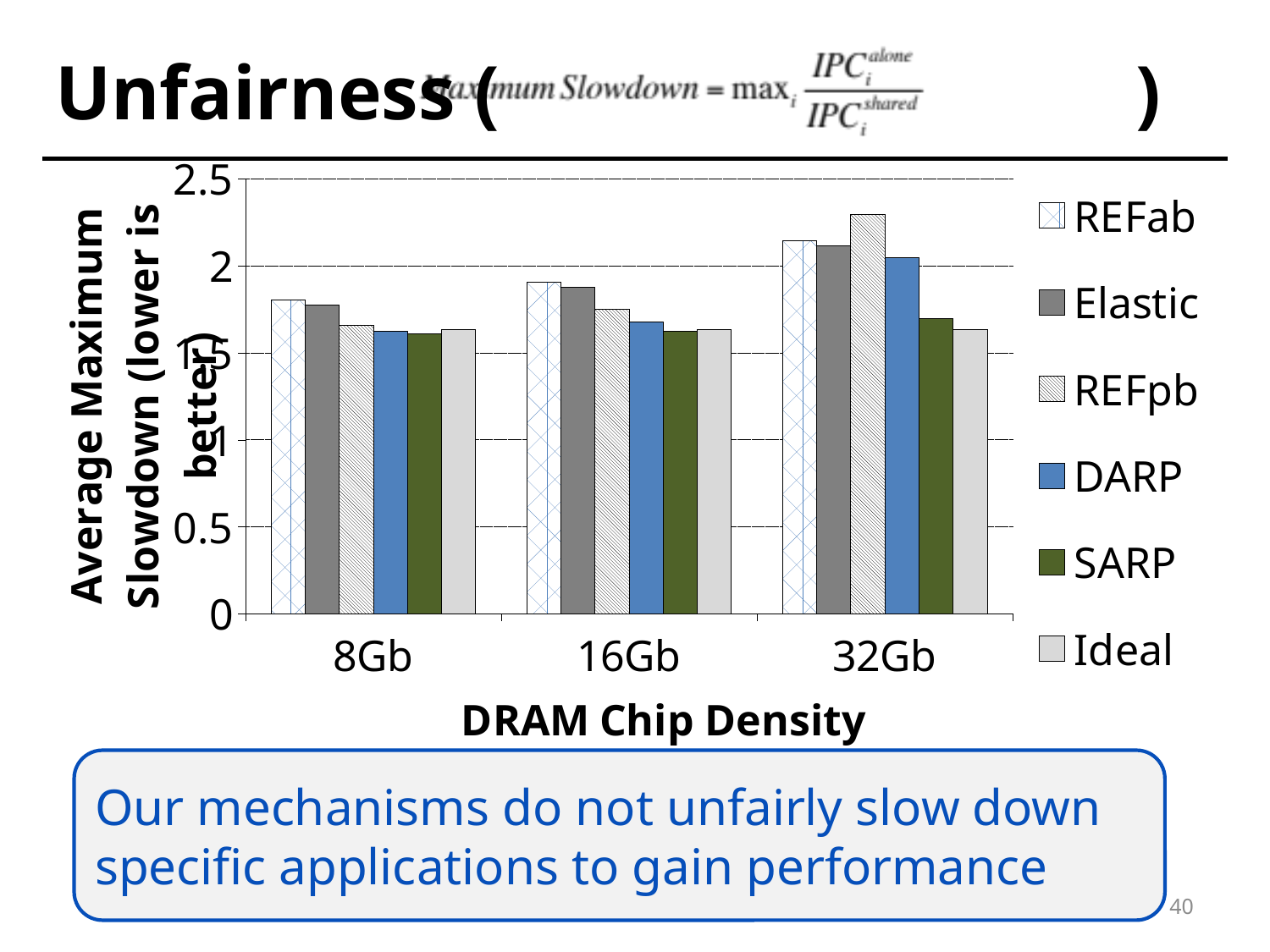
How many series does the legend list? 6 What kind of chart is shown on the slide? bar chart Is the value for SARP at 8Gb greater or less than 1.5? greater Is the value for SARP at 32Gb greater or less than 2? less Is the value for REFpb at 32Gb greater or less than 2? greater Which series is listed first in the legend? REFab Which series has the highest average maximum slowdown at 32Gb? REFpb How many DRAM chip density categories are shown on the x axis? 3 At 32Gb, which is larger: the value for REFpb or the value for SARP? REFpb Does the value for REFab rise or fall as DRAM chip density increases from 8Gb to 32Gb? rise What is the title of the x axis? DRAM Chip Density